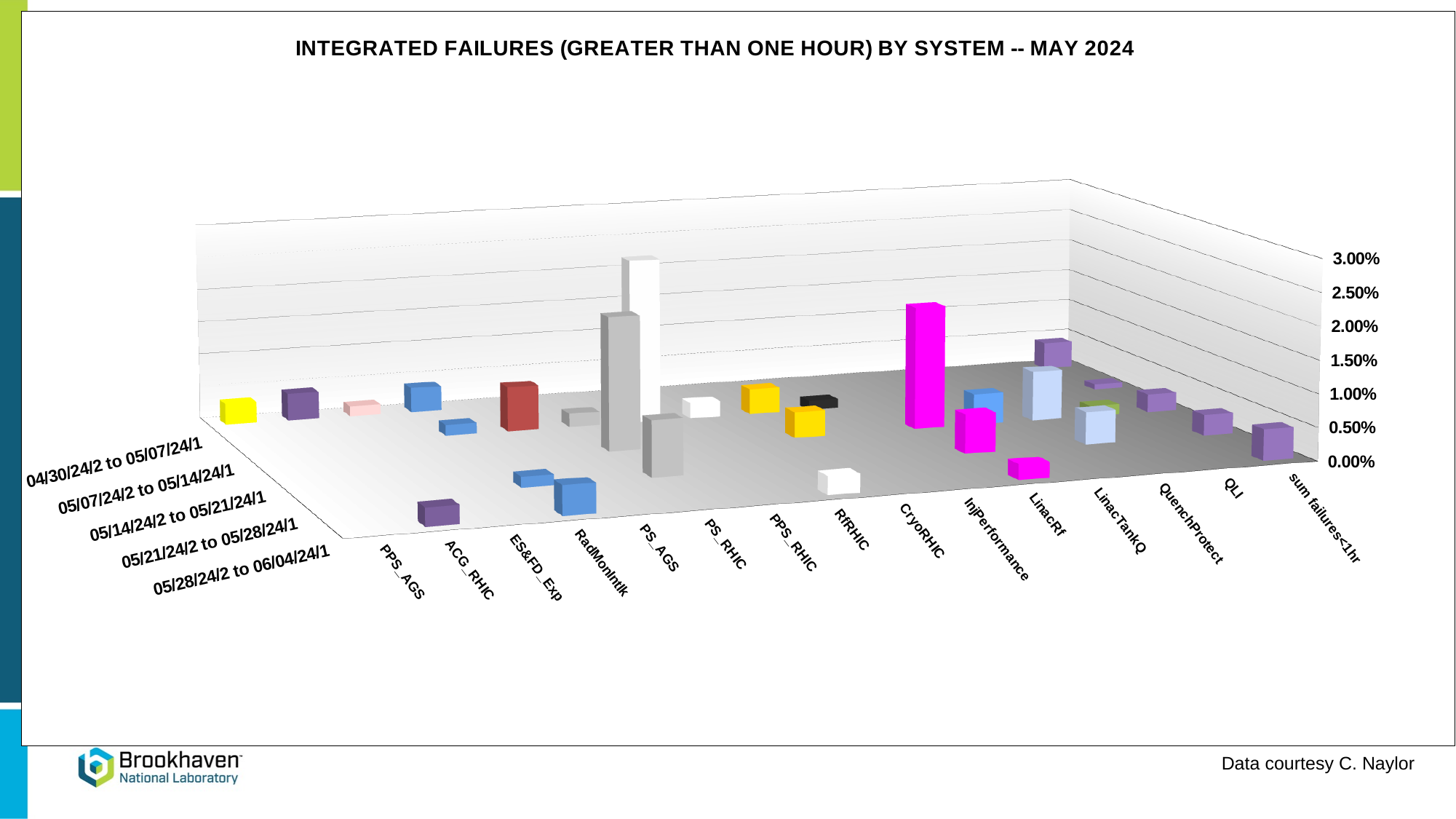
How many systems are listed along the category axis of the chart? 15 Which system has the tallest bar in the chart? PPS_RHIC How many weekly date ranges are shown along the depth axis of the chart? 5 What is the first date range listed on the depth axis of the chart? 04/30/24/2 to 05/07/24/1 Is the tallest bar for PS_AGS greater or less than 1.50%? less Which is larger, the tallest bar for PS_AGS or the tallest bar for CryoRHIC? PS_AGS What is the highest value shown on the percentage axis of the chart? 3.00% What kind of chart is shown on the slide? bar chart Is the tallest bar for PPS_AGS greater or less than 1.00%? less What is the title of the chart? INTEGRATED FAILURES (GREATER THAN ONE HOUR) BY SYSTEM -- MAY 2024 Is the tallest bar for CryoRHIC greater or less than 1.00%? less